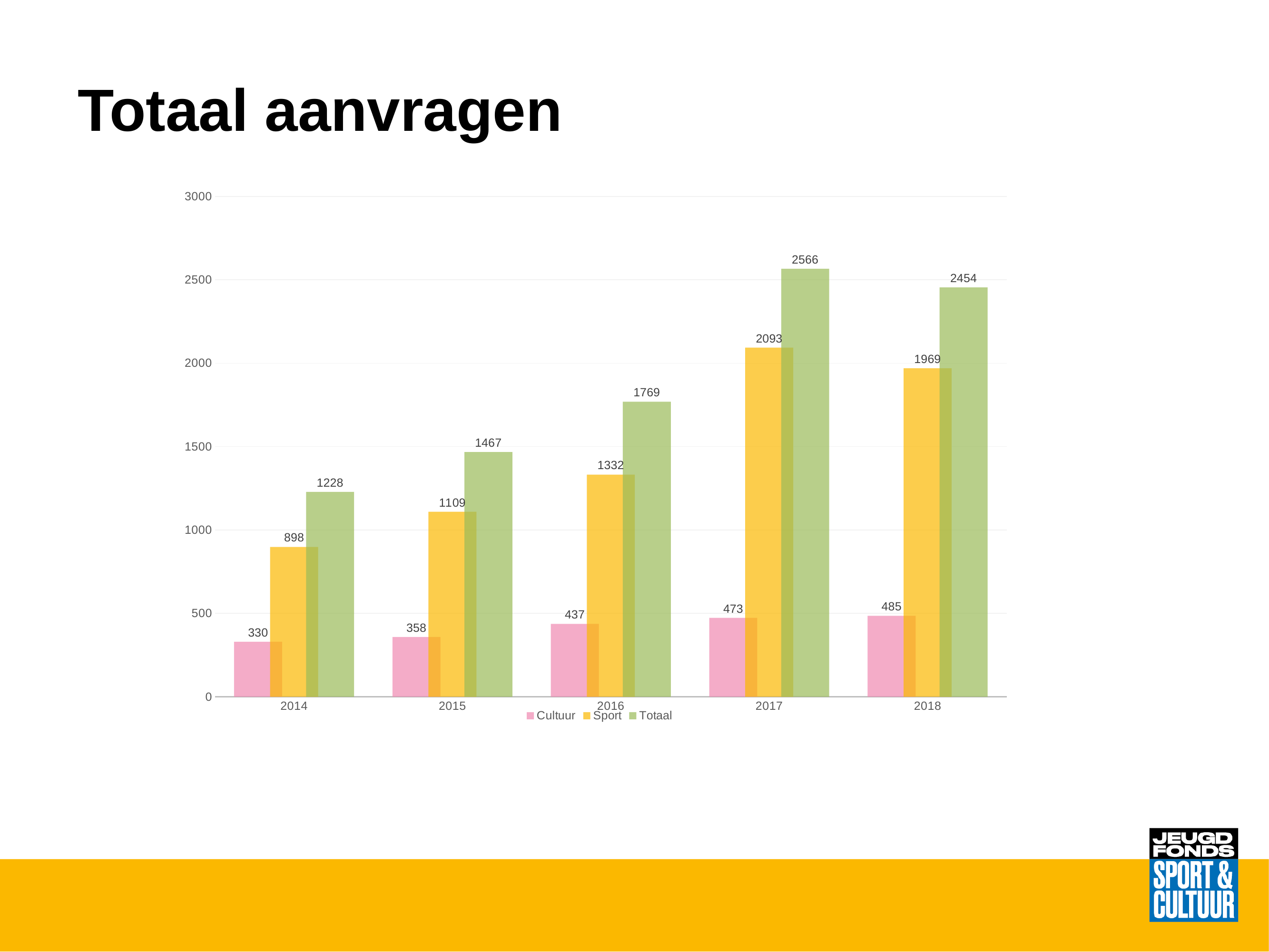
What is the difference between the Totaal values for 2017 and 2018? 112 How many series does the legend list? 3 What is the value for Sport in 2016? 1332 Which is larger, the Sport value in 2017 or the Sport value in 2018? 2017 What is the value for Totaal in 2015? 1467 In which year is the Cultuur value lowest? 2014 Does the Cultuur value rise or fall from 2014 to 2018? rise In which year is the Totaal value highest? 2017 What kind of chart is shown on the slide? bar chart Is the value for Totaal in 2016 greater or less than 1500? greater How many years are shown on the x axis? 5 What is the value for Cultuur in 2018? 485